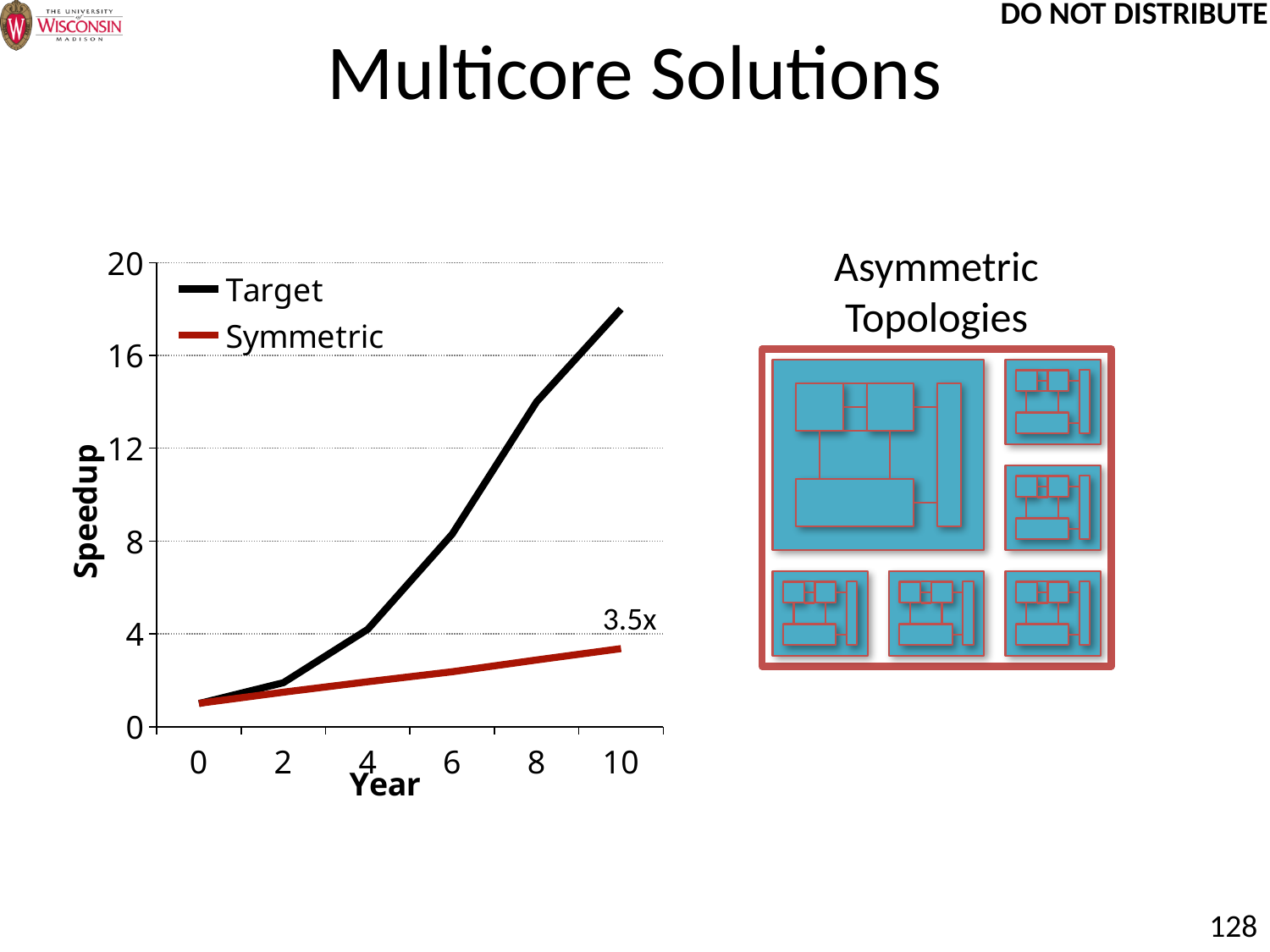
Does the Target line rise or fall as Year increases? rise At Year 10, which series has the higher Speedup, Target or Symmetric? Target Is the Target Speedup at Year 8 greater or less than 12? greater How many series does the chart's legend list? 2 What are the two series named in the chart's legend? Target and Symmetric What is the label of the chart's vertical axis? Speedup Is the Symmetric Speedup at Year 10 greater or less than 4? less What value label is printed at the end of the Symmetric line? 3.5x What kind of chart is shown on the slide? line chart Is the Target Speedup at Year 2 greater or less than 4? less Does the Symmetric line rise or fall as Year increases? rise